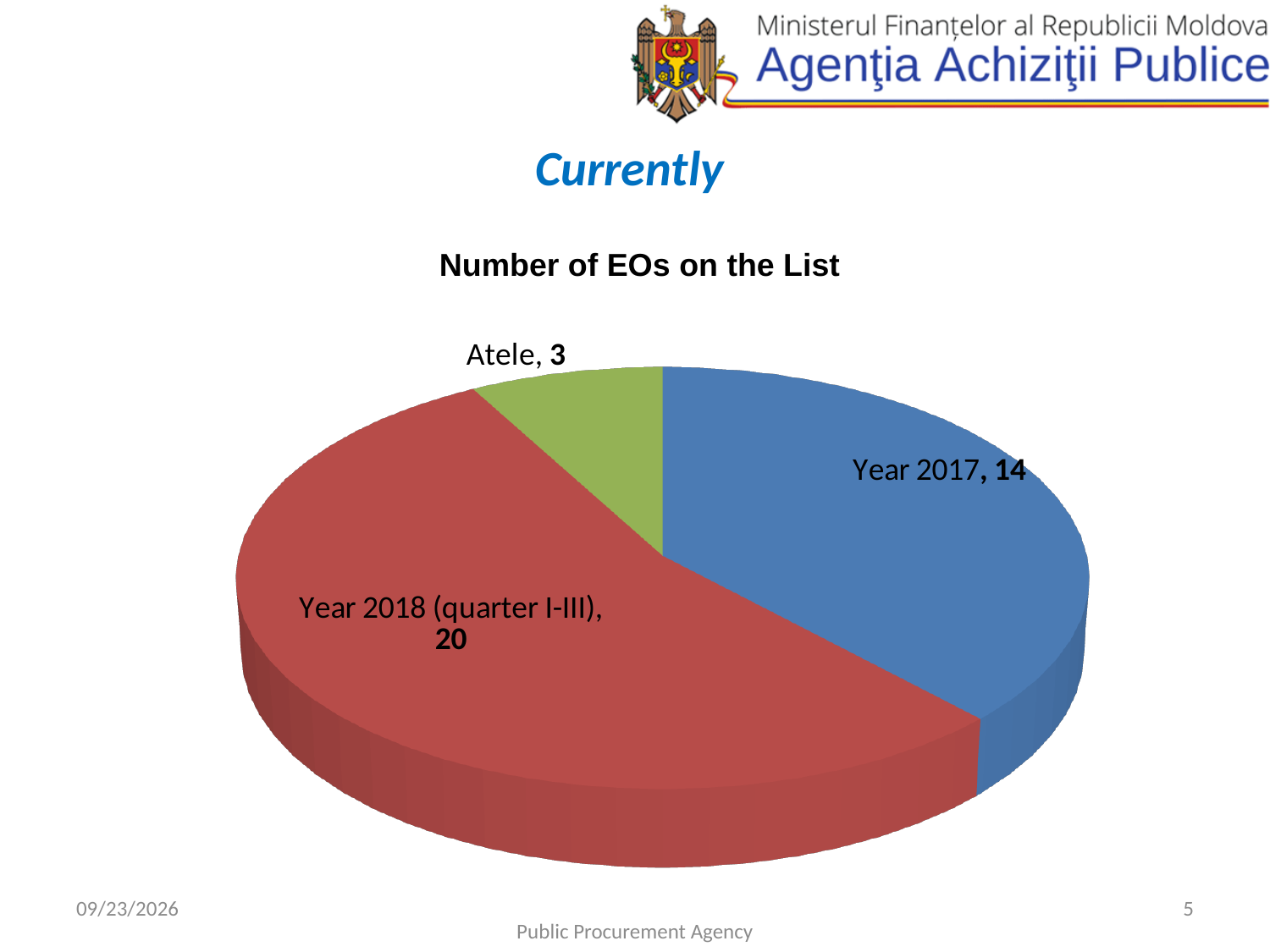
What is the value for Year 2018 (quarter I-III)? 20 What is the total of all slices in the pie chart? 37 Which category has the largest slice? Year 2018 (quarter I-III) Which is larger, the value for Year 2017 or the value for Atele? Year 2017 How many slices does the pie chart have? 3 What is the value for Year 2017? 14 What is the difference between the values for Year 2018 (quarter I-III) and Year 2017? 6 What is the value for Atele? 3 What kind of chart is shown on the slide? pie chart Which category has the smallest slice? Atele Which colour is the slice for Year 2017? blue What is the title of the chart? Number of EOs on the List